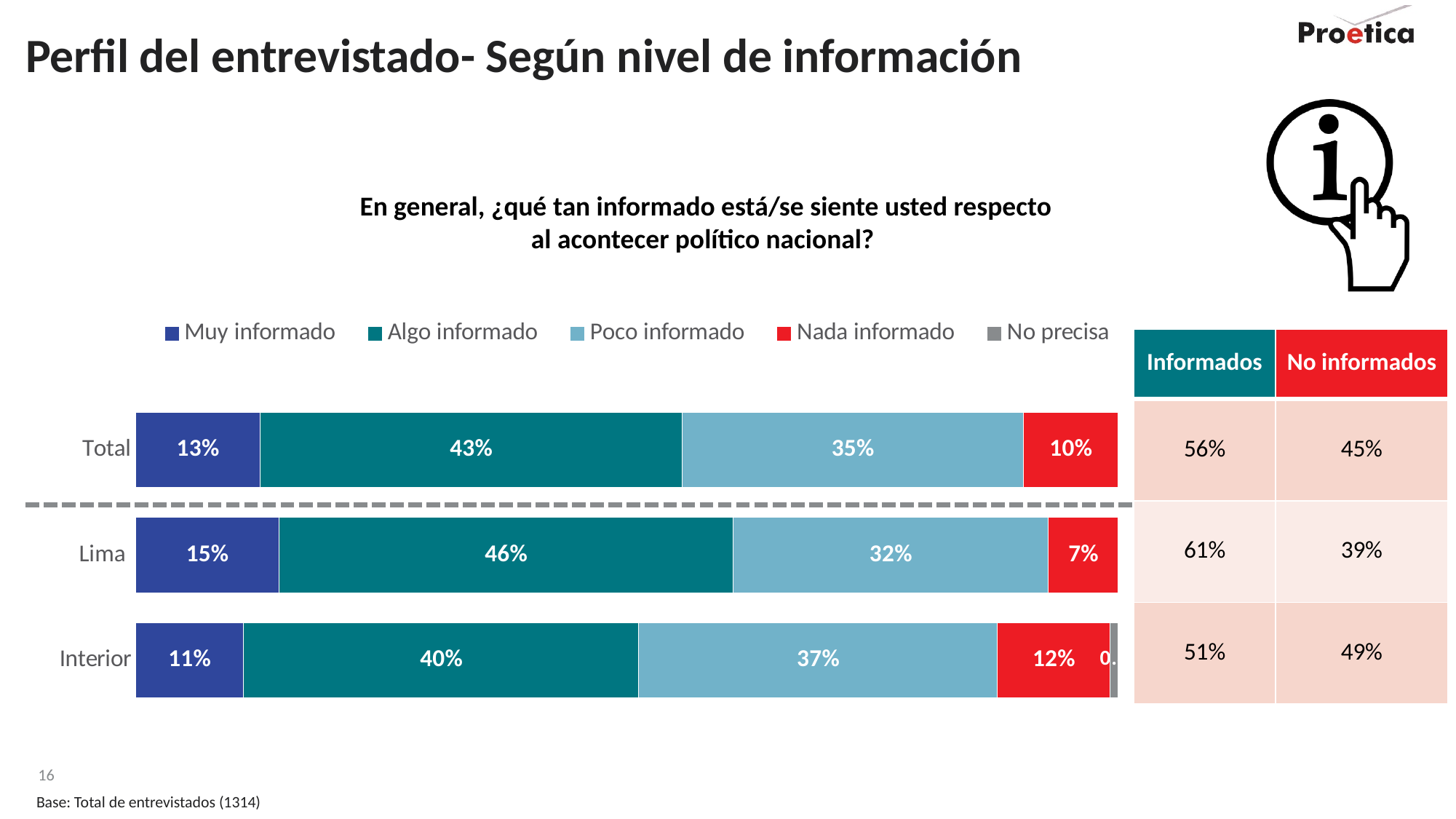
What percentage of respondents in Lima are 'Muy informado'? 15% Which is larger, the 'Poco informado' value for Lima or for Interior? Interior What kind of chart is shown on the slide? Stacked bar chart Which category has the lowest 'Muy informado' value? Interior How many series does the legend list? 5 What is the difference between the 'Algo informado' values for Lima and Interior? 6% What is the 'Nada informado' value for Lima? 7% Which colour represents 'Nada informado' in the legend? Red What is the 'Poco informado' value for Total? 35% Which category has the highest 'Nada informado' value? Interior What is the 'Algo informado' value for Interior? 40% How many categories are shown on the chart? 3